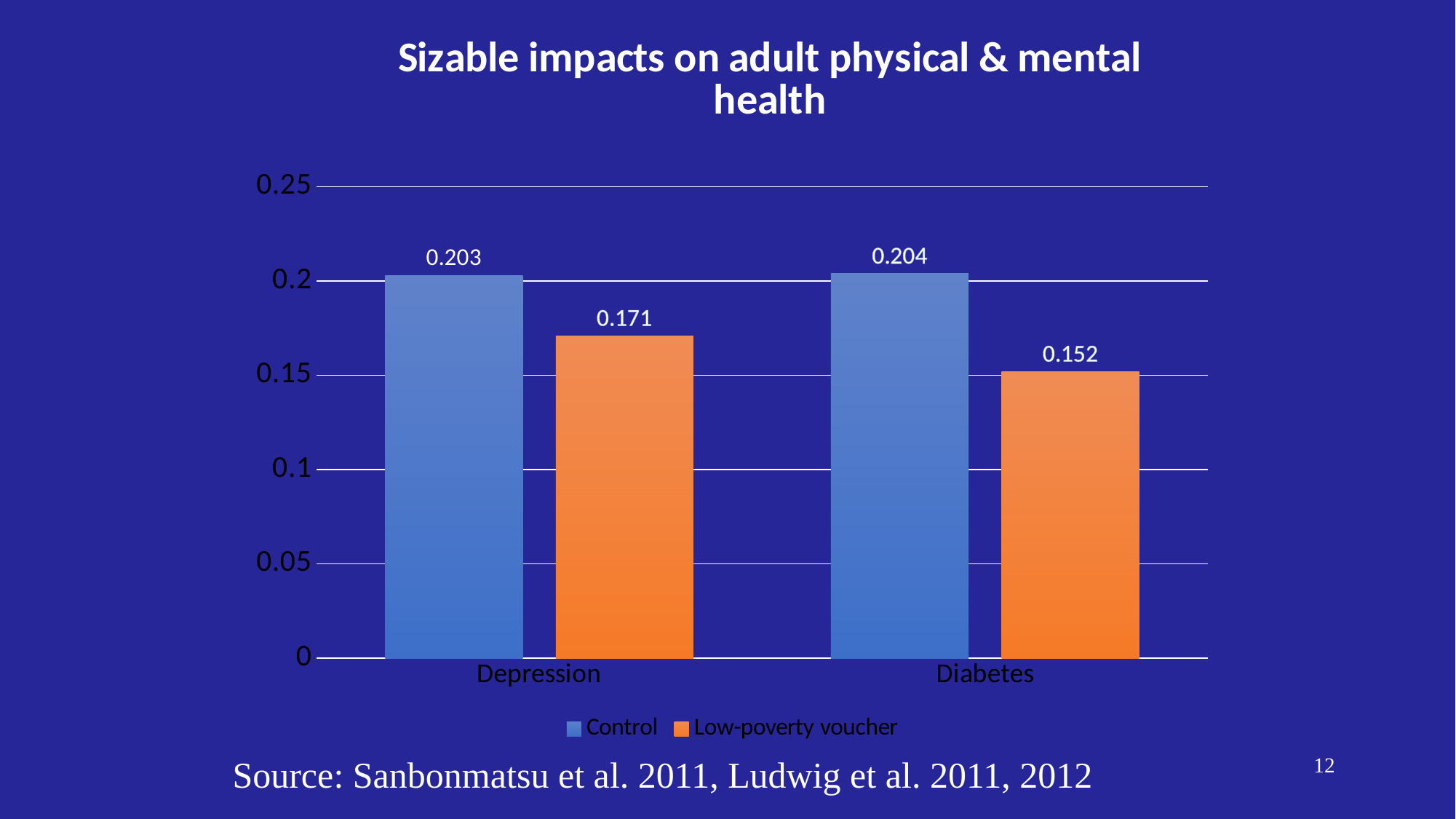
What is the Low-poverty voucher value for Depression? 0.171 What is the Control value for Diabetes? 0.204 Which category has the lowest Low-poverty voucher value? Diabetes What is the difference between the Control and Low-poverty voucher values for Depression? 0.032 How many series does the legend list? 2 For Depression, which is larger: the Control value or the Low-poverty voucher value? Control What is the Control value for Depression? 0.203 Is the Low-poverty voucher value for Depression greater or less than 0.15? greater What kind of chart is shown on the slide? Bar chart What is the difference between the Control and Low-poverty voucher values for Diabetes? 0.052 How many categories are shown on the x axis? 2 What is the Low-poverty voucher value for Diabetes? 0.152